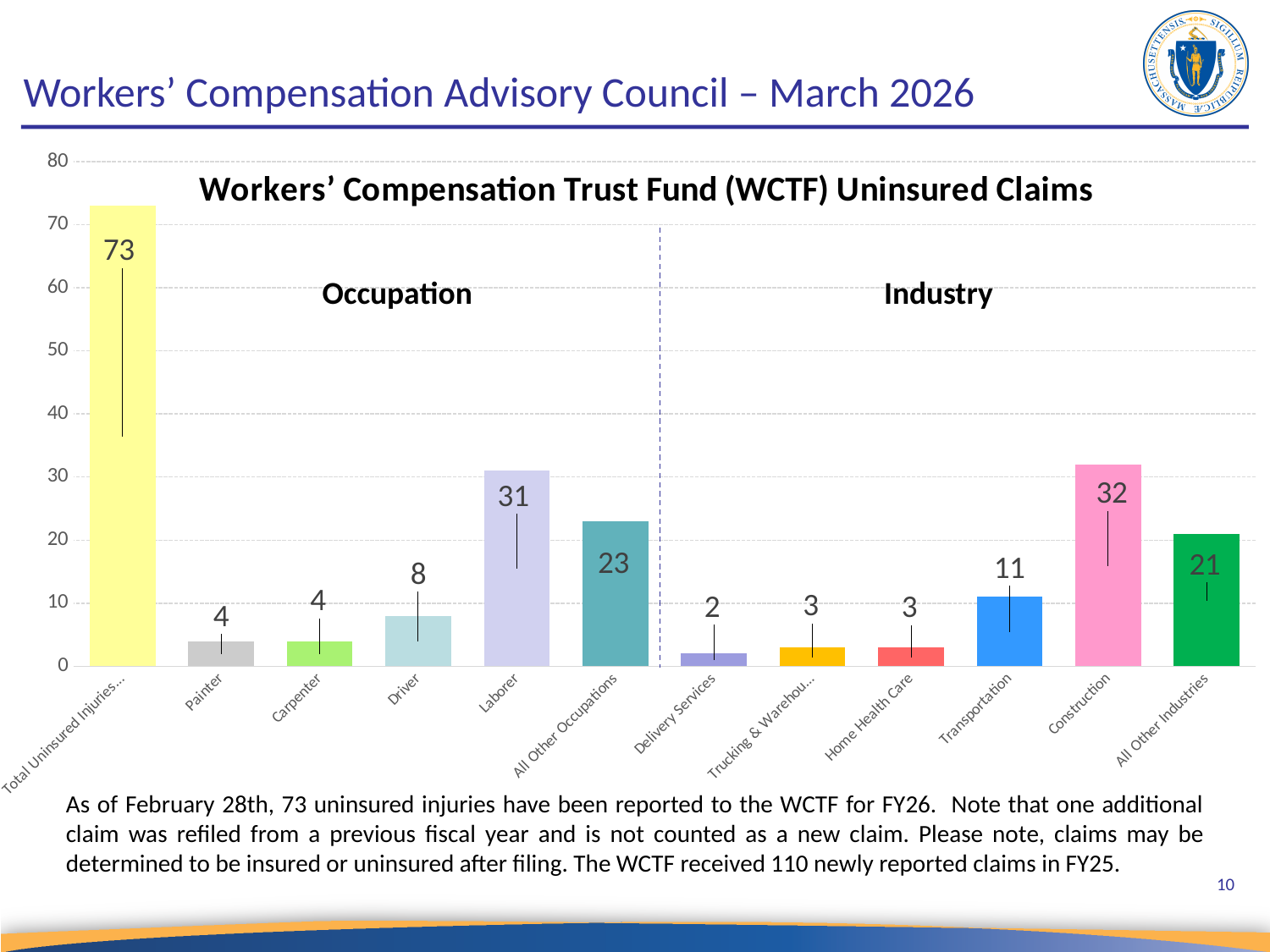
What kind of chart is this? Bar chart What is the difference between the values for All Other Occupations and Driver? 15 What is the value for Construction? 32 What is the title of the chart? Workers' Compensation Trust Fund (WCTF) Uninsured Claims What is the difference between the values for Construction and Laborer? 1 What is the value for All Other Industries? 21 Which is larger, the value for Transportation or the value for Driver? Transportation How many categories are shown on the x axis? 12 What is the value for Transportation? 11 Which category has the highest value? Total Uninsured Injuries Which category has the lowest value? Delivery Services What is the value for Laborer? 31